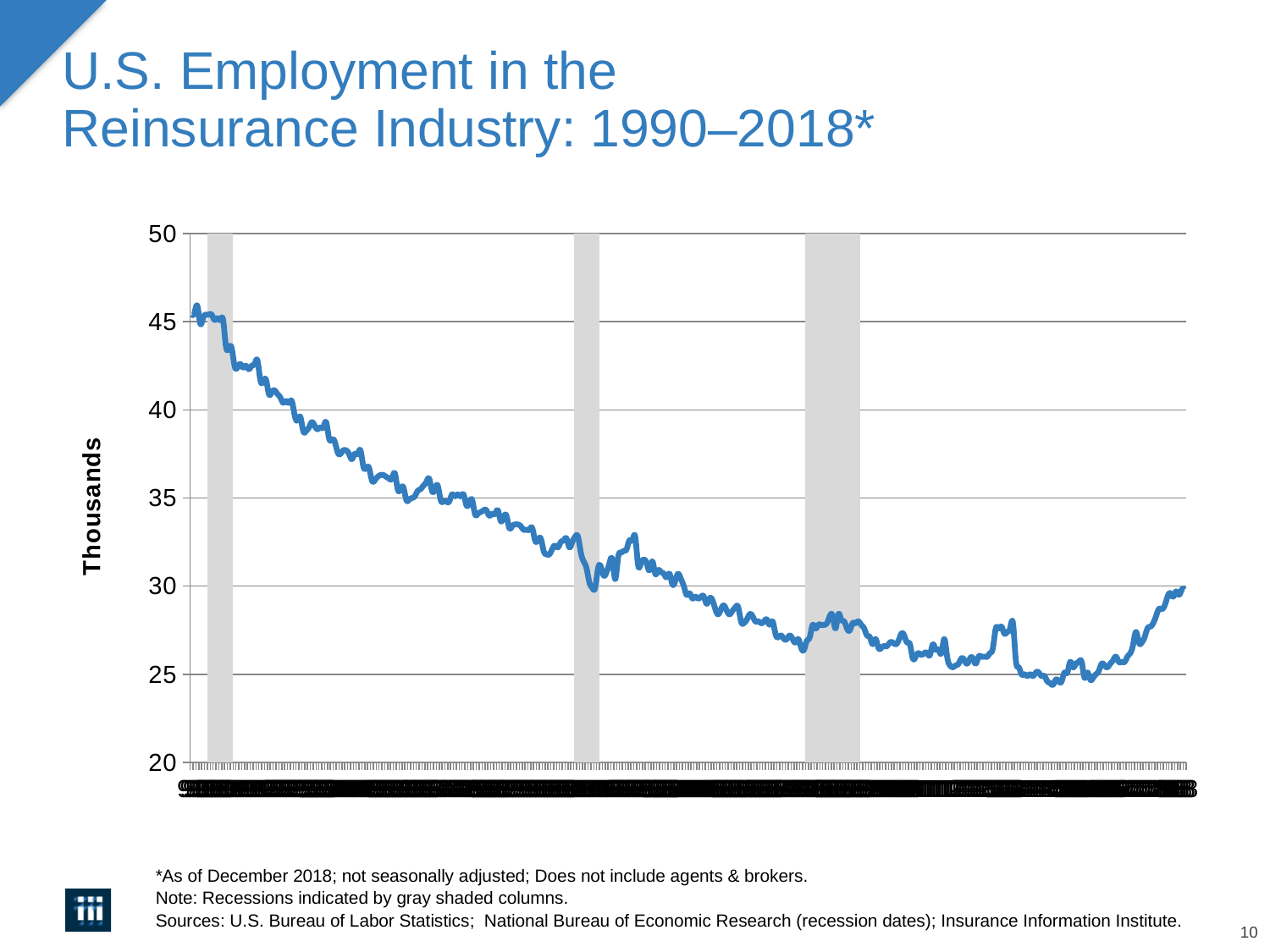
How many gray shaded recession columns are shown on the chart? 3 Which is larger, the value at the start of the series or the value at the end of the series? the value at the start Is the highest point of the line greater or less than 45? greater What is the highest value shown on the vertical axis? 50 Is the value at the start of the series (left end) greater or less than 45? greater What is the label on the vertical axis? Thousands Overall, do the values rise or fall from the left end of the x axis to the right end? fall Is the value at the end of the series (right end) greater or less than 35? less What is the title of the slide? U.S. Employment in the Reinsurance Industry: 1990–2018* What kind of chart is shown on the slide? line chart